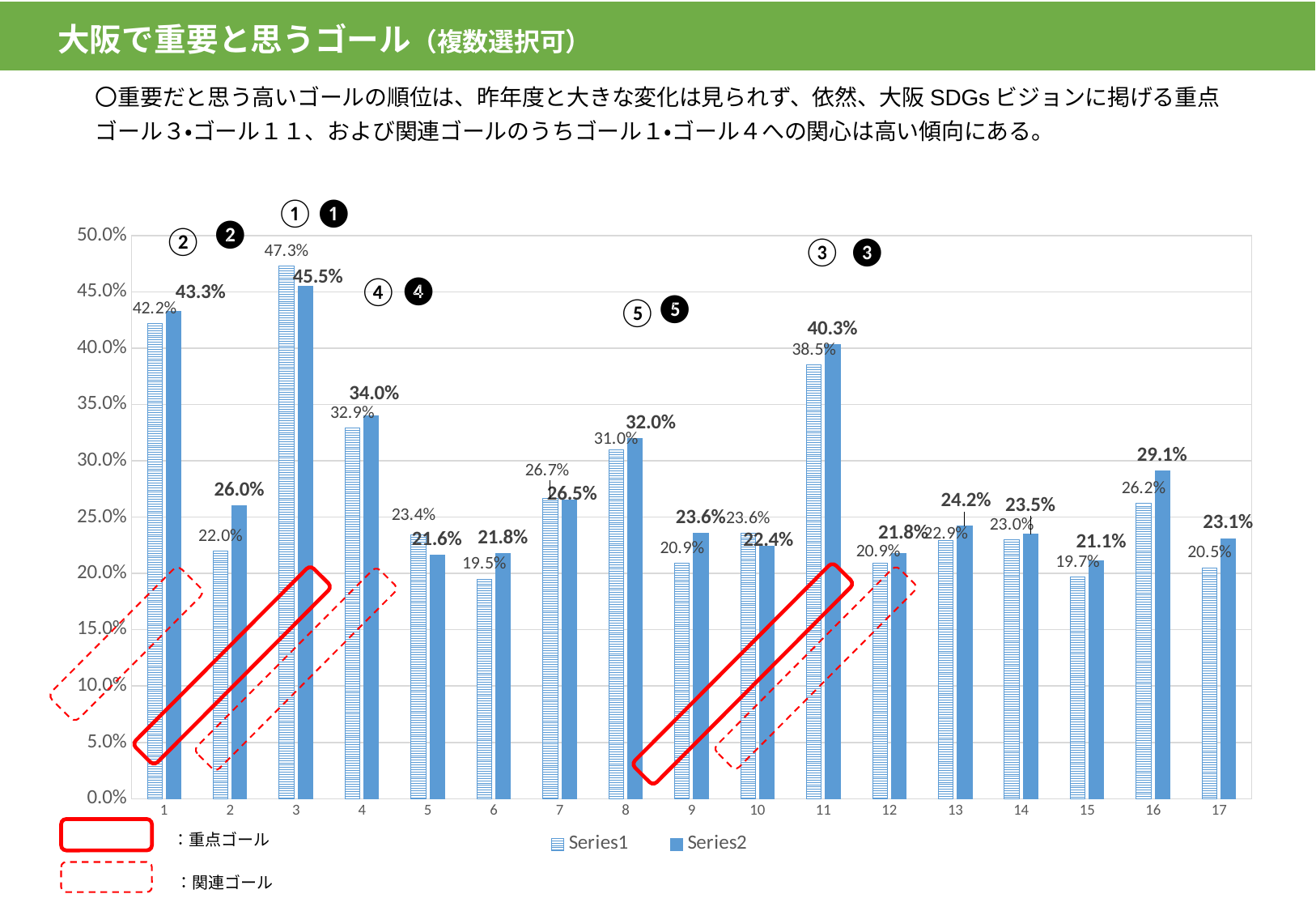
What is the Series2 value for category 16? 29.1% Which category has the highest Series1 value? 3 What is the difference between the Series2 and Series1 values for category 2? 4.0% What is the Series2 value for category 3? 45.5% What kind of chart is shown on the slide? Bar chart Is the Series2 value for category 11 greater or less than 40.0%? greater What is the Series1 value for category 11? 38.5% For category 3, which is larger, Series1 or Series2? Series1 What is the Series1 value for category 1? 42.2% How many categories are shown on the x axis? 17 How many series does the legend list? 2 Which category has the lowest Series1 value? 6